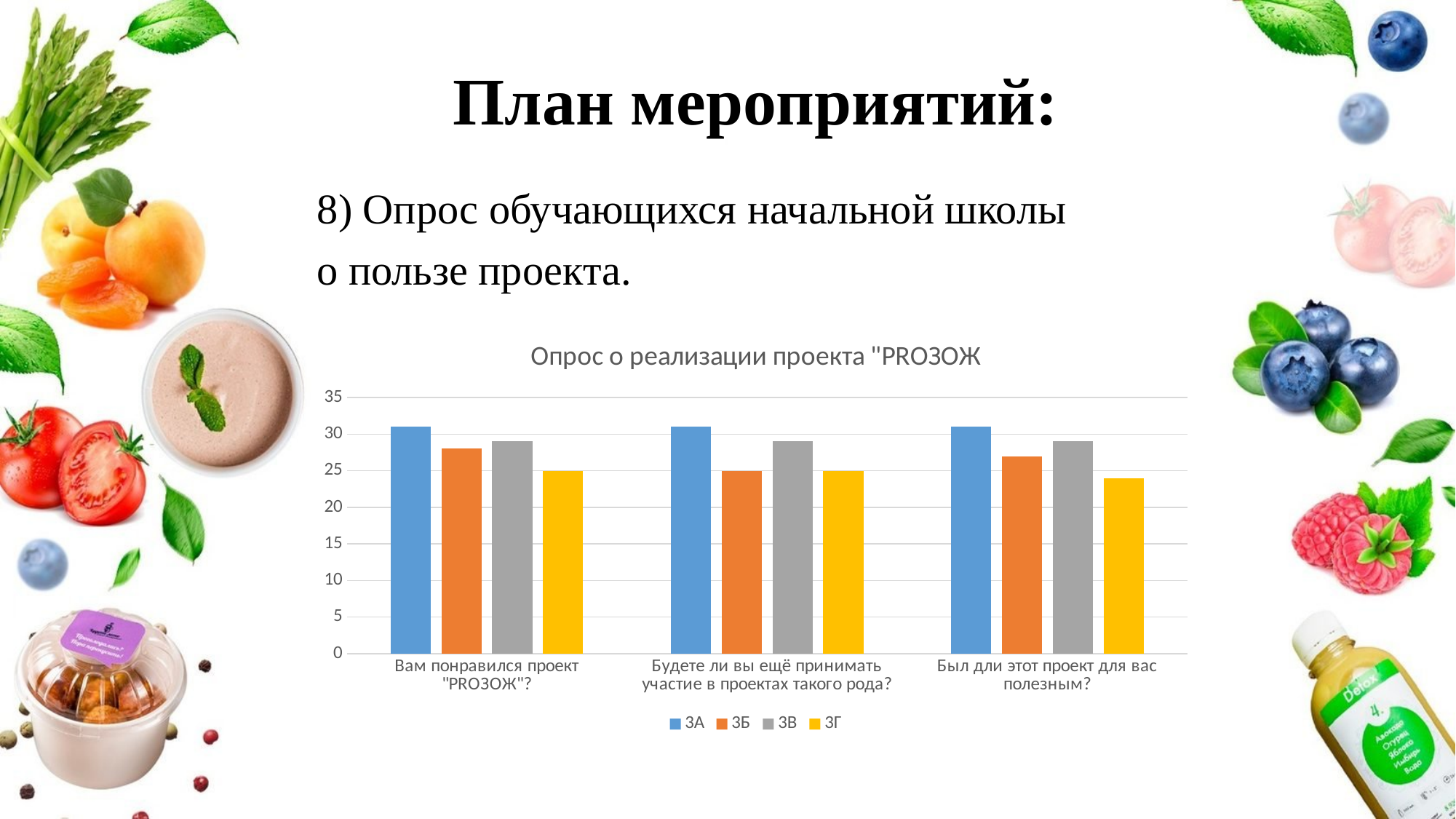
Which series has the highest bar for "Вам понравился проект "PROЗОЖ"?"? 3А What kind of chart is shown on the slide? bar chart Is the value for 3Б in "Вам понравился проект "PROЗОЖ"?" greater or less than 25? greater How many question categories are shown on the x axis? 3 Which colour represents the 3Г series in the legend? yellow Is the value for 3В in "Был дли этот проект для вас полезным?" greater or less than 25? greater For "Будете ли вы ещё принимать участие в проектах такого рода?", which is larger: 3Б or 3В? 3В What is the title of the chart? Опрос о реализации проекта "PROЗОЖ Is the value for 3А in "Был дли этот проект для вас полезным?" greater or less than 35? less How many series does the legend list? 4 Which series has the lowest bar for "Был дли этот проект для вас полезным?"? 3Г Which series has the lowest bar for "Вам понравился проект "PROЗОЖ"?"? 3Г